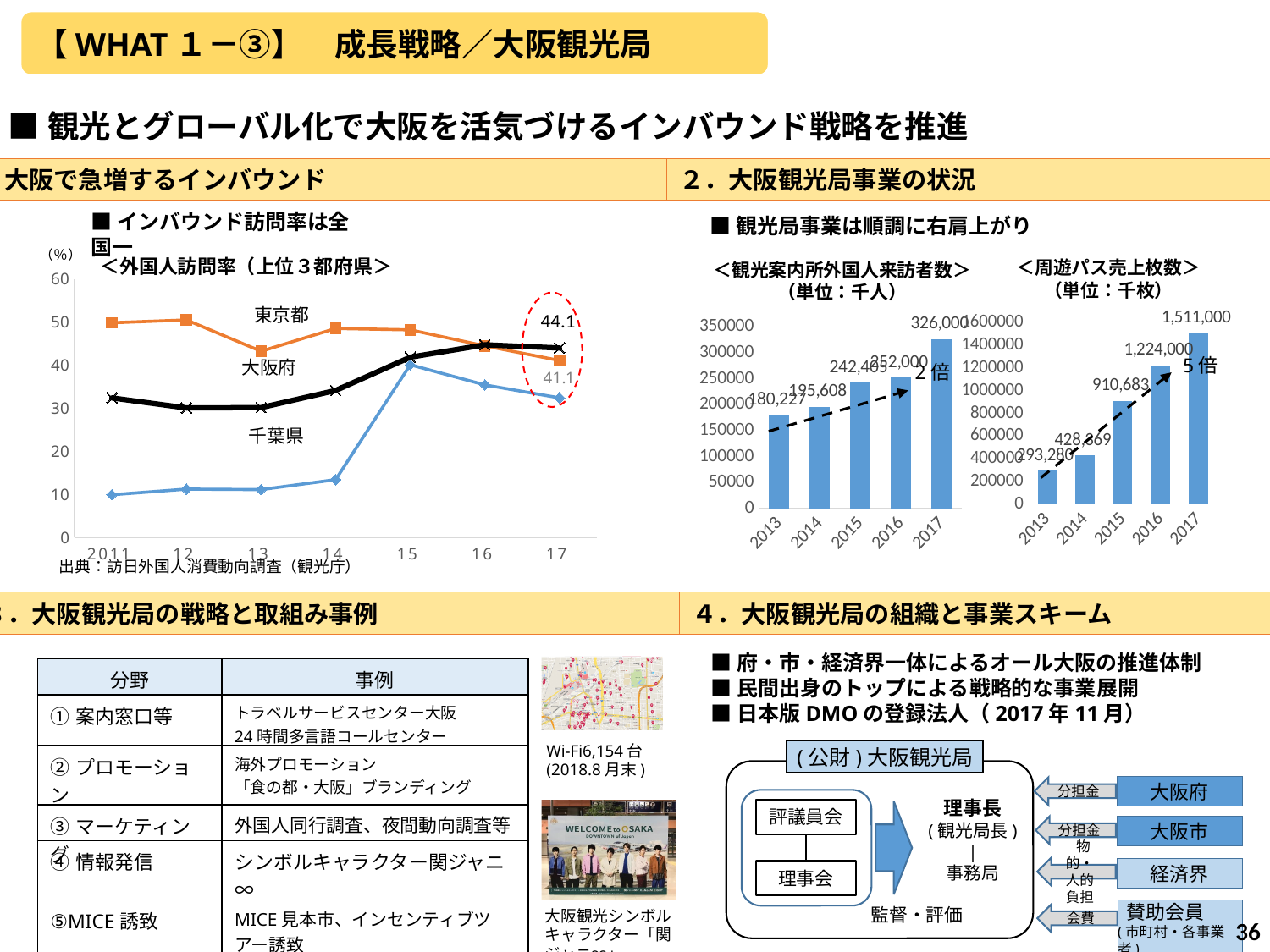
In the chart 周遊パス売上枚数, what is the value for 2017? 1,511,000 In the line chart 外国人訪問率（上位3都府県）, which prefecture has the lowest value in 2011? 千葉県 In the line chart 外国人訪問率（上位3都府県）, which is larger in 2017, 大阪府 or 東京都? 大阪府 What kind of chart is 外国人訪問率（上位3都府県）? line chart In the line chart 外国人訪問率（上位3都府県）, what is the value for 東京都 in 2017? 41.1 In the chart 観光案内所外国人来訪者数, what is the value for 2017? 326,000 In the chart 周遊パス売上枚数, what is the difference between the 2017 and 2016 values? 287,000 In the chart 観光案内所外国人来訪者数, what is the difference between the 2017 and 2013 values? 145,773 In the line chart 外国人訪問率（上位3都府県）, what is the value for 大阪府 in 2017? 44.1 How many years are shown on the x axis of the chart 周遊パス売上枚数? 5 In the line chart 外国人訪問率（上位3都府県）, is the value for 千葉県 in 2011 greater or less than 20? less In the chart 観光案内所外国人来訪者数, do the values rise or fall from 2013 to 2017? rise